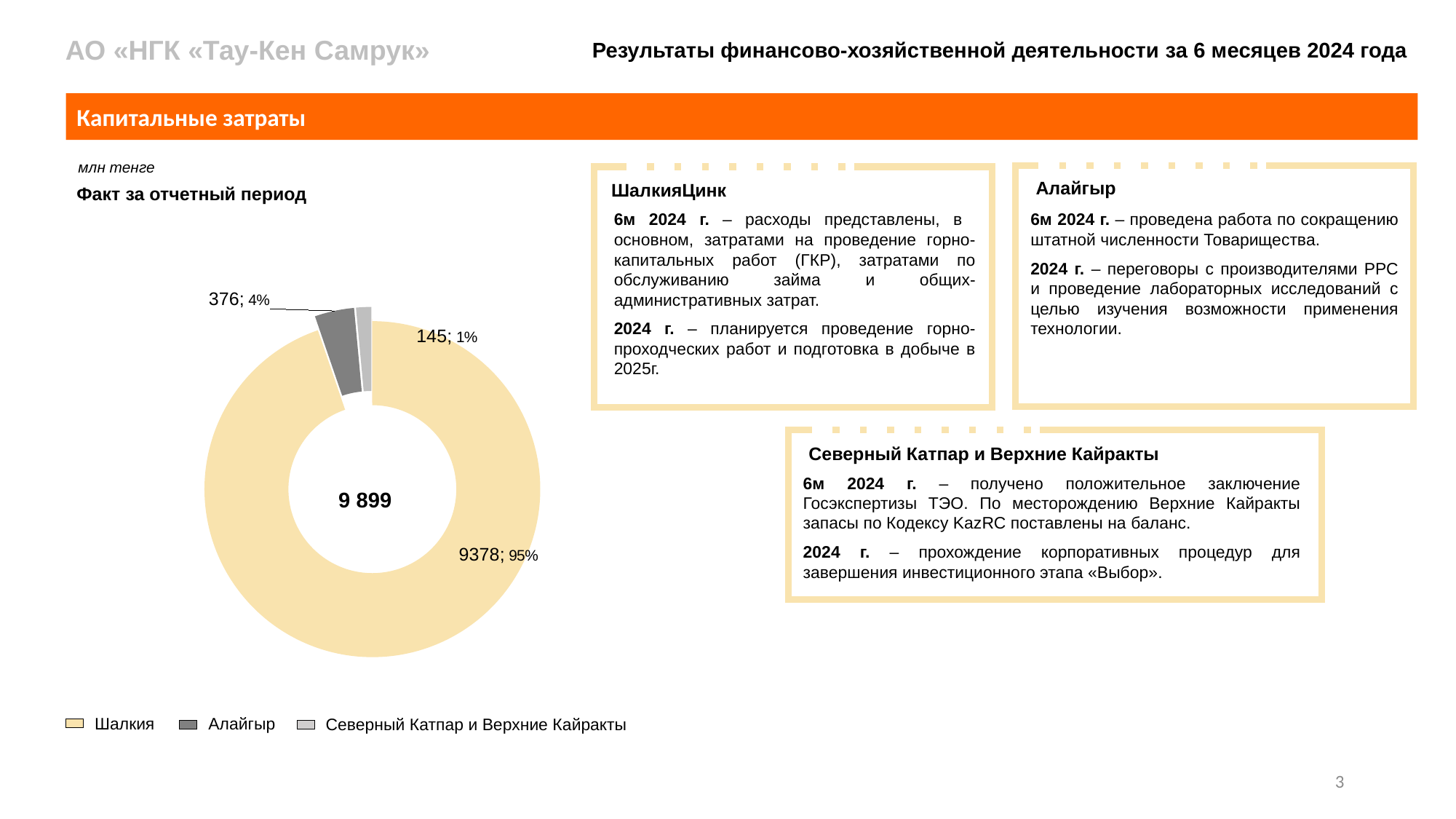
What is the difference between the values for Алайгыр and Северный Катпар и Верхние Кайракты? 231 How many categories does the donut chart show? 3 Which is larger, the value for Алайгыр or the value for Северный Катпар и Верхние Кайракты? Алайгыр What is the value for Северный Катпар и Верхние Кайракты in the donut chart? 145 What is the value for Шалкия in the donut chart? 9378 Which category has the largest slice in the donut chart? Шалкия What share of the donut chart does Алайгыр account for? 4% What kind of chart is shown on the slide? Donut (pie) chart What share of the donut chart does Шалкия account for? 95% What is the value for Алайгыр in the donut chart? 376 What total value is printed in the centre of the donut chart? 9 899 Which category has the smallest slice in the donut chart? Северный Катпар и Верхние Кайракты